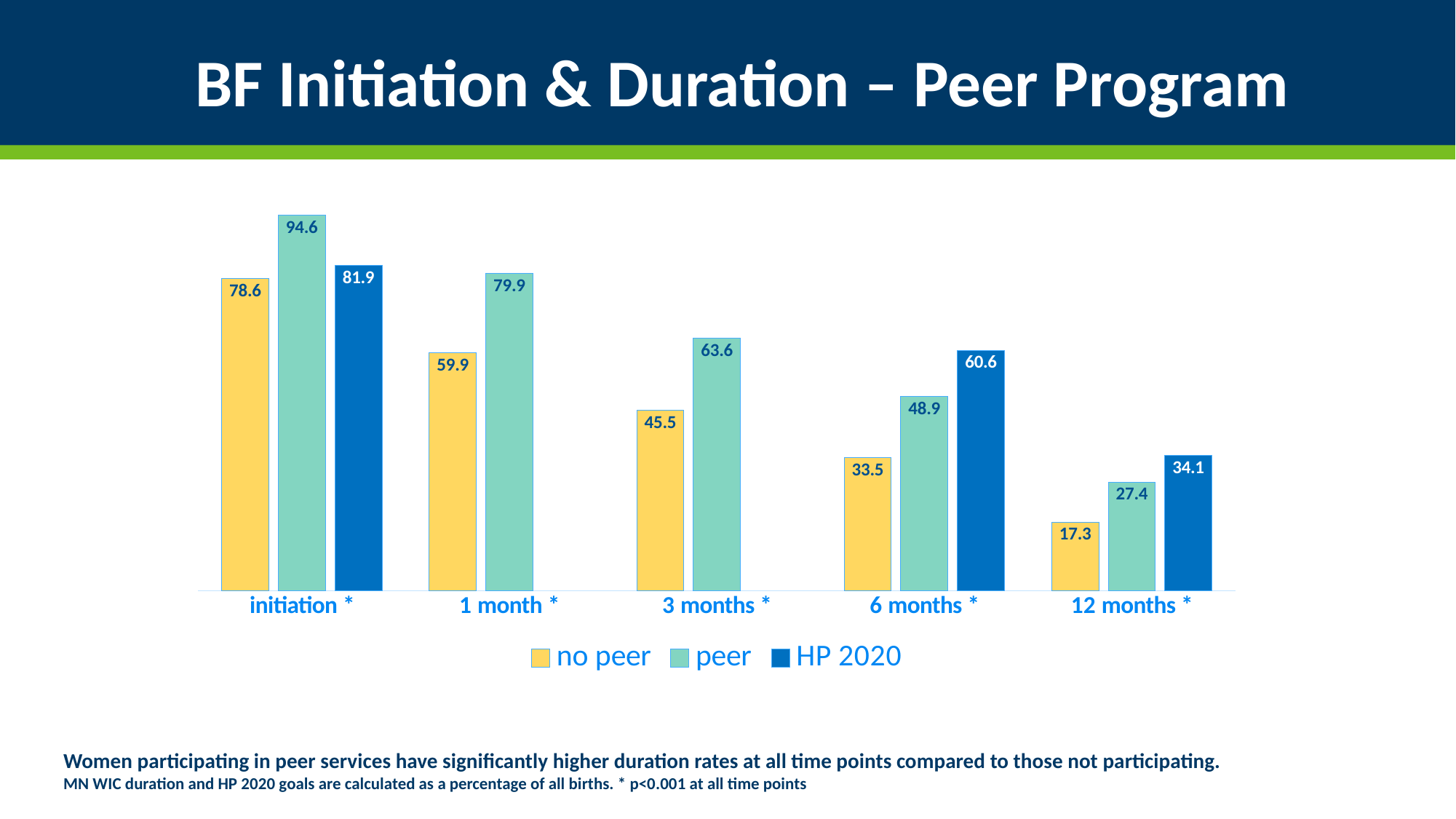
Which category has the lowest "no peer" value? 12 months What is the value for "no peer" at 3 months? 45.5 What is the difference between the "peer" and "no peer" values at 1 month? 20 What is the difference between the HP 2020 value and the "peer" value at 6 months? 11.7 How many categories are shown on the x axis? 5 What is the value for "peer" at 12 months? 27.4 What is the value for "peer" at initiation? 94.6 What is the HP 2020 value at 6 months? 60.6 Which category has the highest "peer" value? initiation What kind of chart is shown on the slide? bar chart Which is larger at initiation: the "peer" value or the HP 2020 value? peer How many series does the legend list? 3